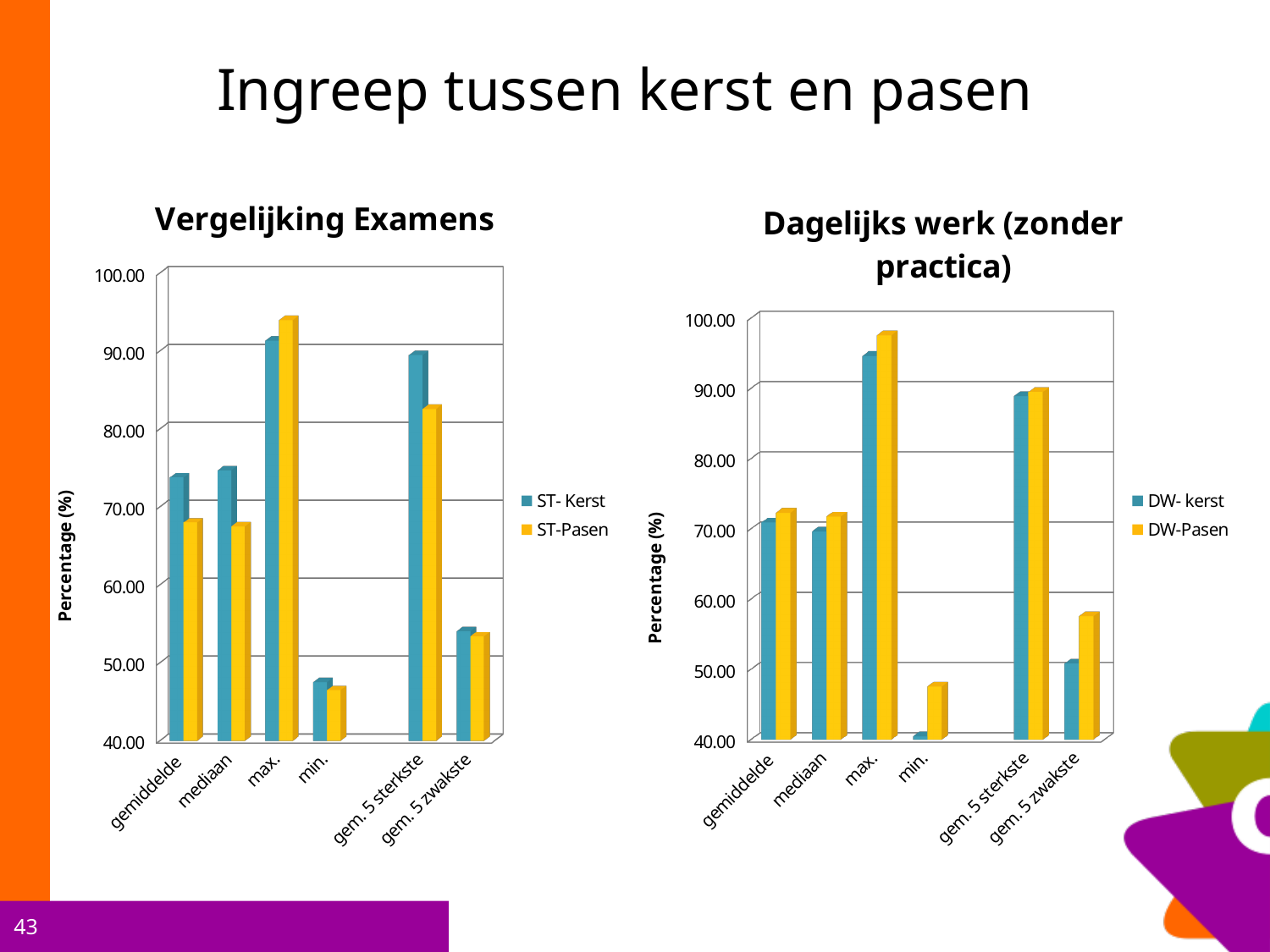
In the 'Vergelijking Examens' chart, for 'gemiddelde', which series is larger: ST- Kerst or ST-Pasen? ST- Kerst What are the two legend entries of the 'Dagelijks werk (zonder practica)' chart? DW- kerst and DW-Pasen In the 'Vergelijking Examens' chart, which category has the highest ST-Pasen value? max. How many categories are shown on the x axis of the 'Vergelijking Examens' chart? 6 How many series does the legend of the 'Vergelijking Examens' chart list? 2 In the 'Dagelijks werk (zonder practica)' chart, for 'gem. 5 zwakste', which series is larger: DW- kerst or DW-Pasen? DW-Pasen In the 'Vergelijking Examens' chart, which category has the lowest ST- Kerst value? min. In the 'Dagelijks werk (zonder practica)' chart, which category has the lowest DW- kerst value? min. What kind of chart is the 'Vergelijking Examens' chart on the left? bar chart In the 'Dagelijks werk (zonder practica)' chart, is the DW-Pasen value for 'min.' greater or less than 50.00? less In the 'Vergelijking Examens' chart, is the ST- Kerst value for 'gem. 5 sterkste' greater or less than 80.00? greater What is the y-axis title of the 'Dagelijks werk (zonder practica)' chart? Percentage (%)